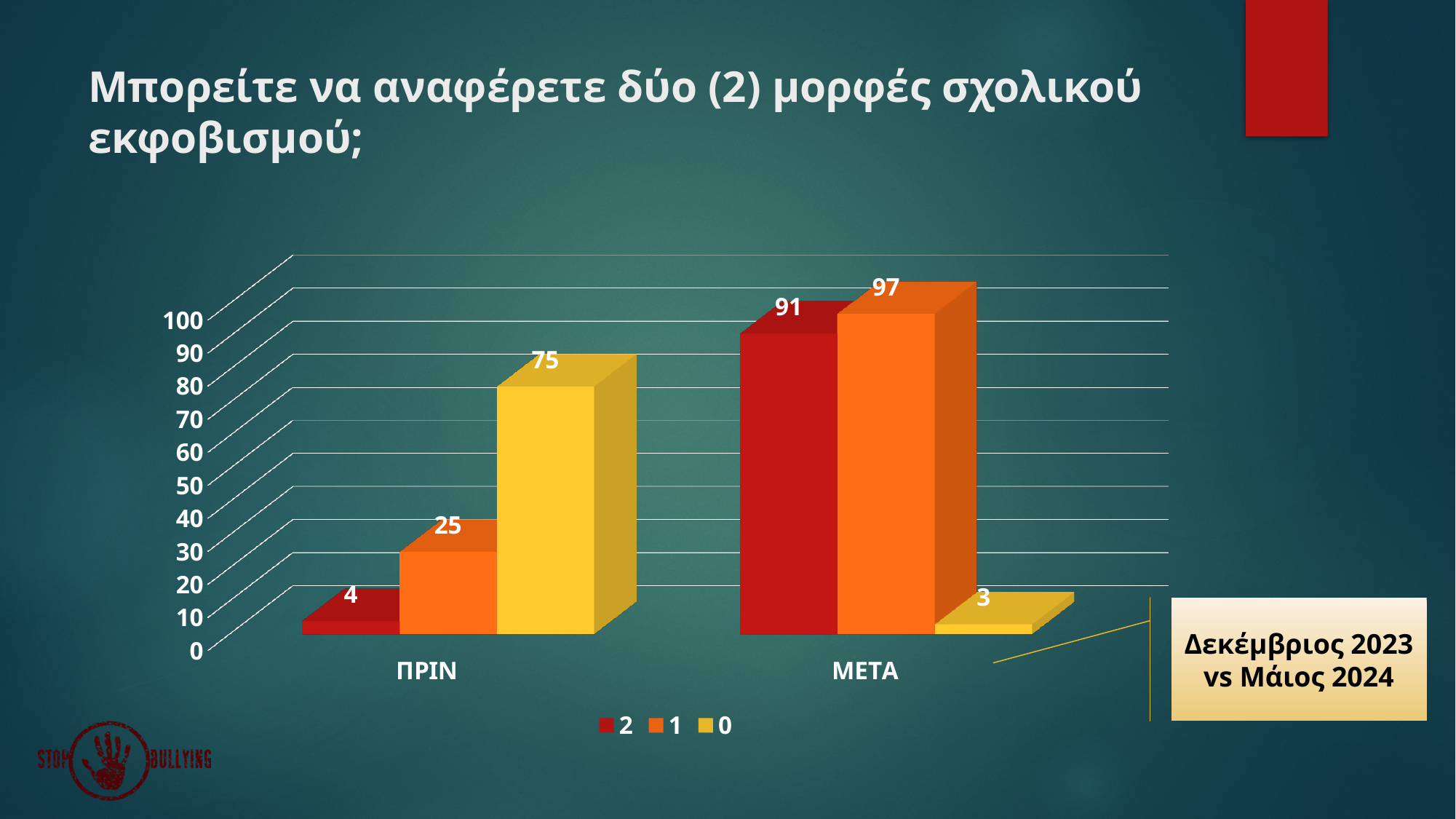
How many series does the legend list? 3 Which series has the highest value in the ΜΕΤΑ category? 1 What are the two category labels on the x axis? ΠΡΙΝ and ΜΕΤΑ Which is larger: the value for series "1" in ΠΡΙΝ or the value for series "0" in ΠΡΙΝ? series 0 in ΠΡΙΝ What is the value for series "0" in the ΜΕΤΑ category? 3 What is the difference between the value for series "2" in ΜΕΤΑ and in ΠΡΙΝ? 87 What is the value for series "2" in the ΠΡΙΝ category? 4 How many categories are shown on the x axis? 2 What is the value for series "0" in the ΠΡΙΝ category? 75 What is the value for series "1" in the ΜΕΤΑ category? 97 Which series has the lowest value in the ΠΡΙΝ category? 2 What kind of chart is shown on the slide? bar chart